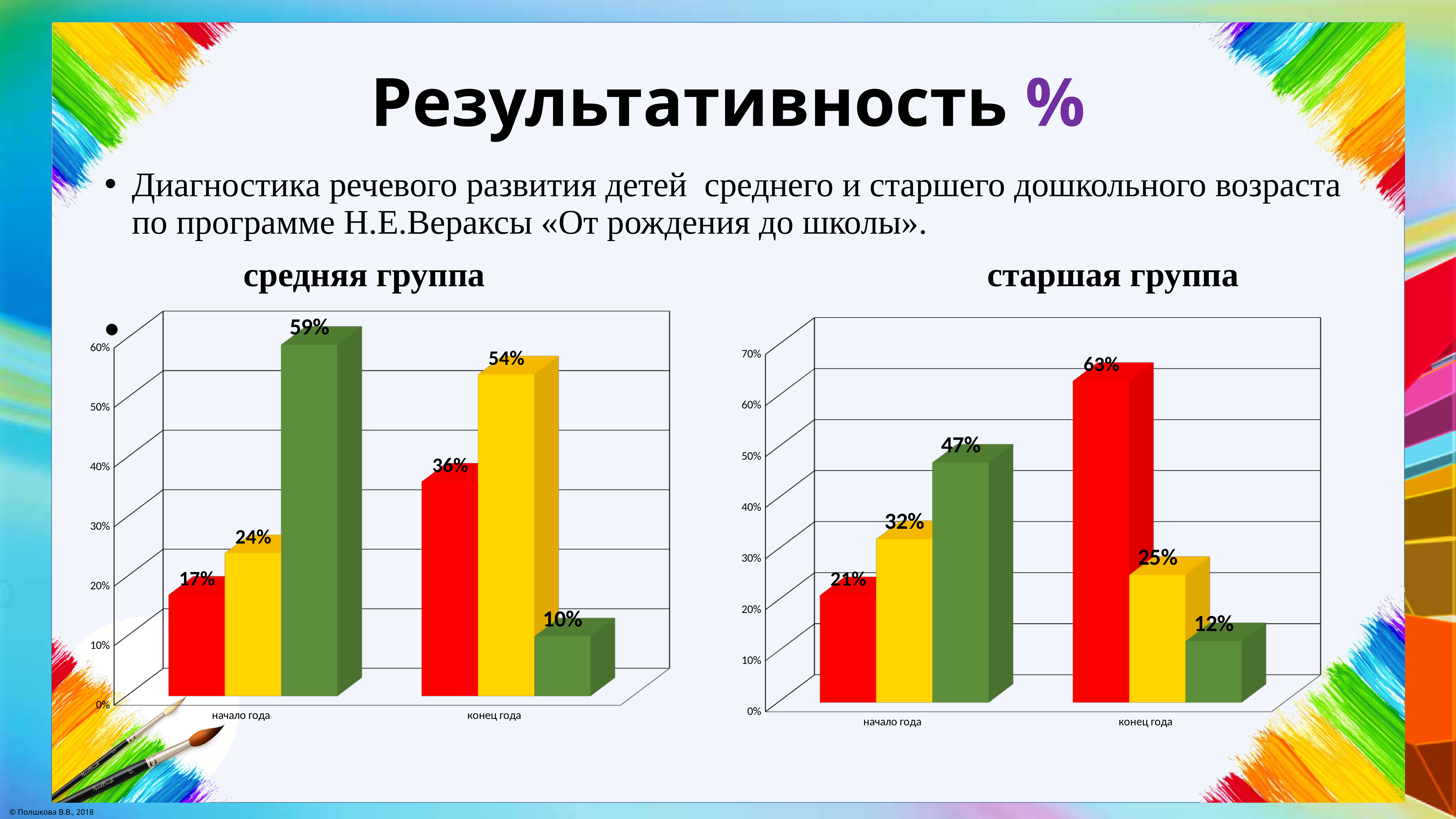
In the chart titled «средняя группа», which bar is the highest? the green bar for «начало года» (59%) In the chart titled «старшая группа», which is larger: the green bar for «начало года» or the yellow bar for «начало года»? the green bar (47%) In the chart titled «старшая группа», what is the value of the red bar for «конец года»? 63% In the chart titled «средняя группа», what is the value of the red bar for «начало года»? 17% In the chart titled «средняя группа», what is the difference between the yellow bar for «конец года» and the yellow bar for «начало года»? 30% How many categories are shown on the x axis of the chart titled «старшая группа»? 2 In the chart titled «старшая группа», which bar is the lowest? the green bar for «конец года» (12%) What type of chart is the chart titled «средняя группа»? bar chart In the chart titled «старшая группа», what is the difference between the red bar for «конец года» and the red bar for «начало года»? 42% In the chart titled «средняя группа», is the value of the red bar for «конец года» greater or less than 30%? greater In the chart titled «старшая группа», what is the value of the yellow bar for «начало года»? 32% In the chart titled «средняя группа», what is the value of the green bar for «конец года»? 10%